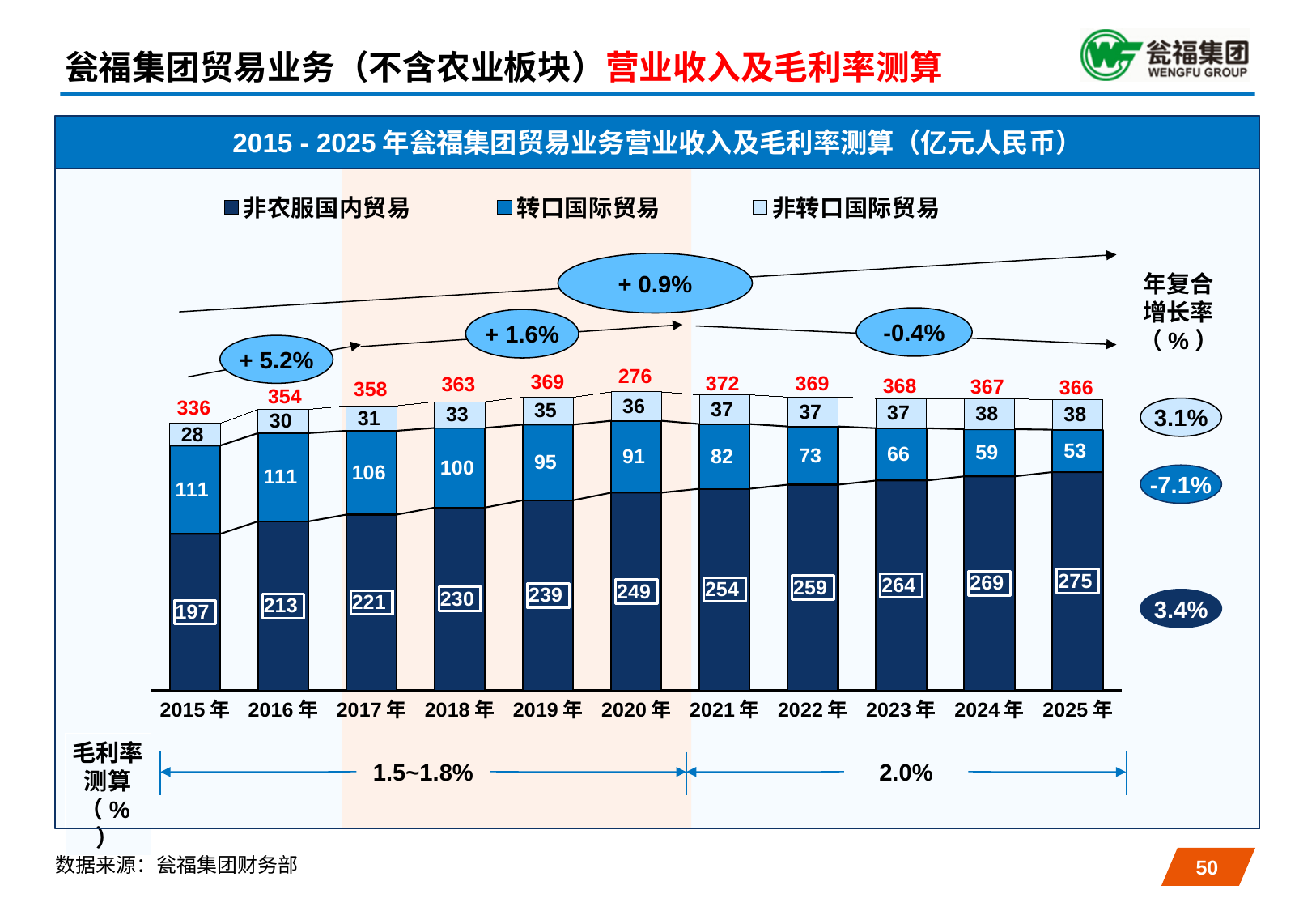
What is the value of 非农服国内贸易 in 2018年? 230 How many years are shown on the x axis? 11 How many series does the legend list? 3 What type of chart is shown on the slide? stacked bar chart What is the value of 非转口国际贸易 in 2025年? 38 Does 转口国际贸易 rise or fall from 2017年 to 2025年? fall What is the value of 转口国际贸易 in 2021年? 82 What total is printed above the bar for 2015年? 336 In which year is 非农服国内贸易 highest? 2025年 Which is larger: 转口国际贸易 in 2016年 or in 2020年? 2016年 What is the difference between 非农服国内贸易 in 2025年 and in 2015年? 78 In which year is 转口国际贸易 lowest? 2025年